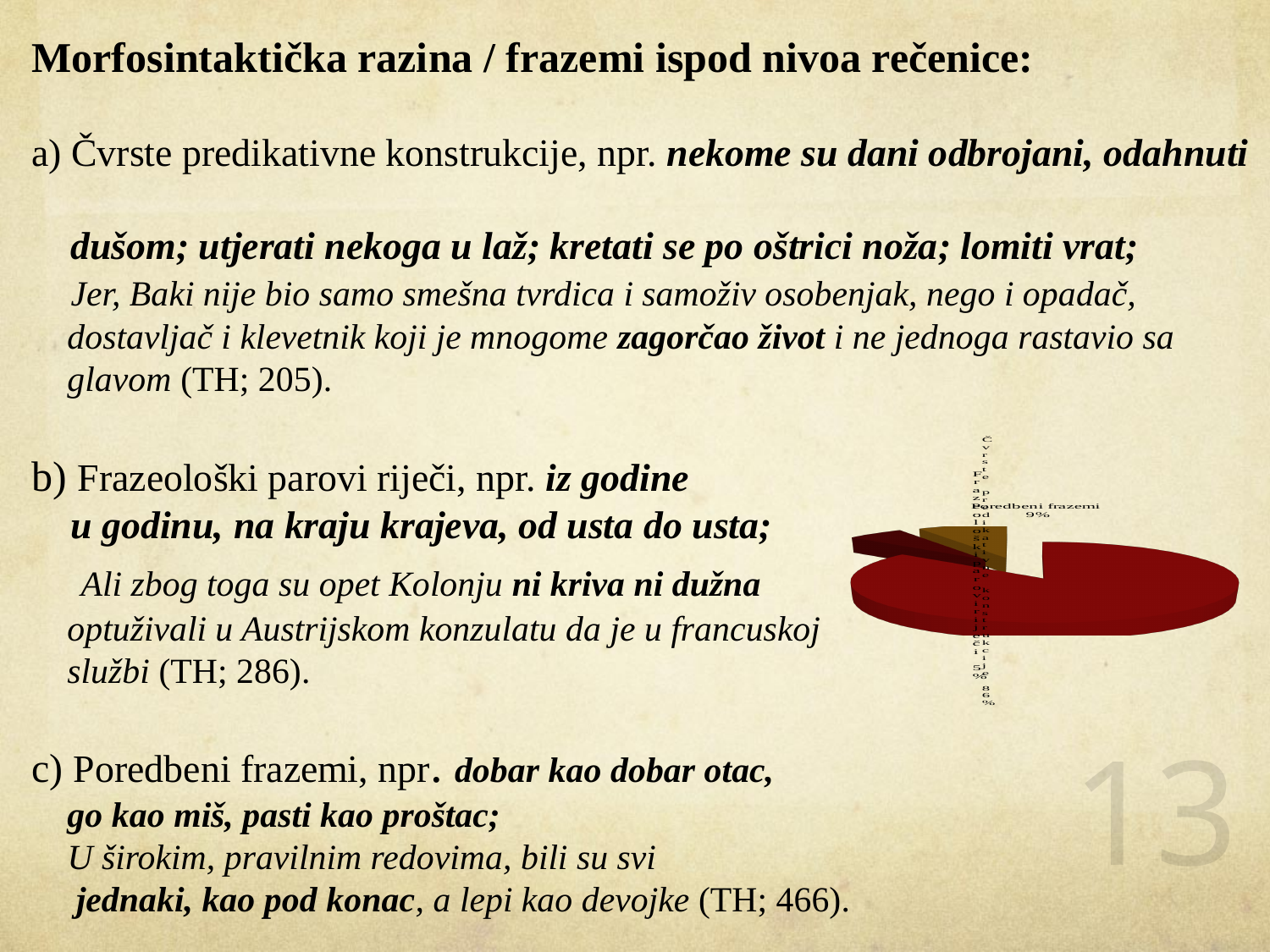
Which slice is larger: the dark red slice or the slice labelled Poredbeni frazemi? the dark red slice What share of the pie does the Poredbeni frazemi slice take? 9% What kind of chart is shown on the slide? pie chart How many slices does the pie chart have? 3 What colour is the largest slice of the pie chart? dark red What percentage is shown for the slice labelled Poredbeni frazemi? 9%